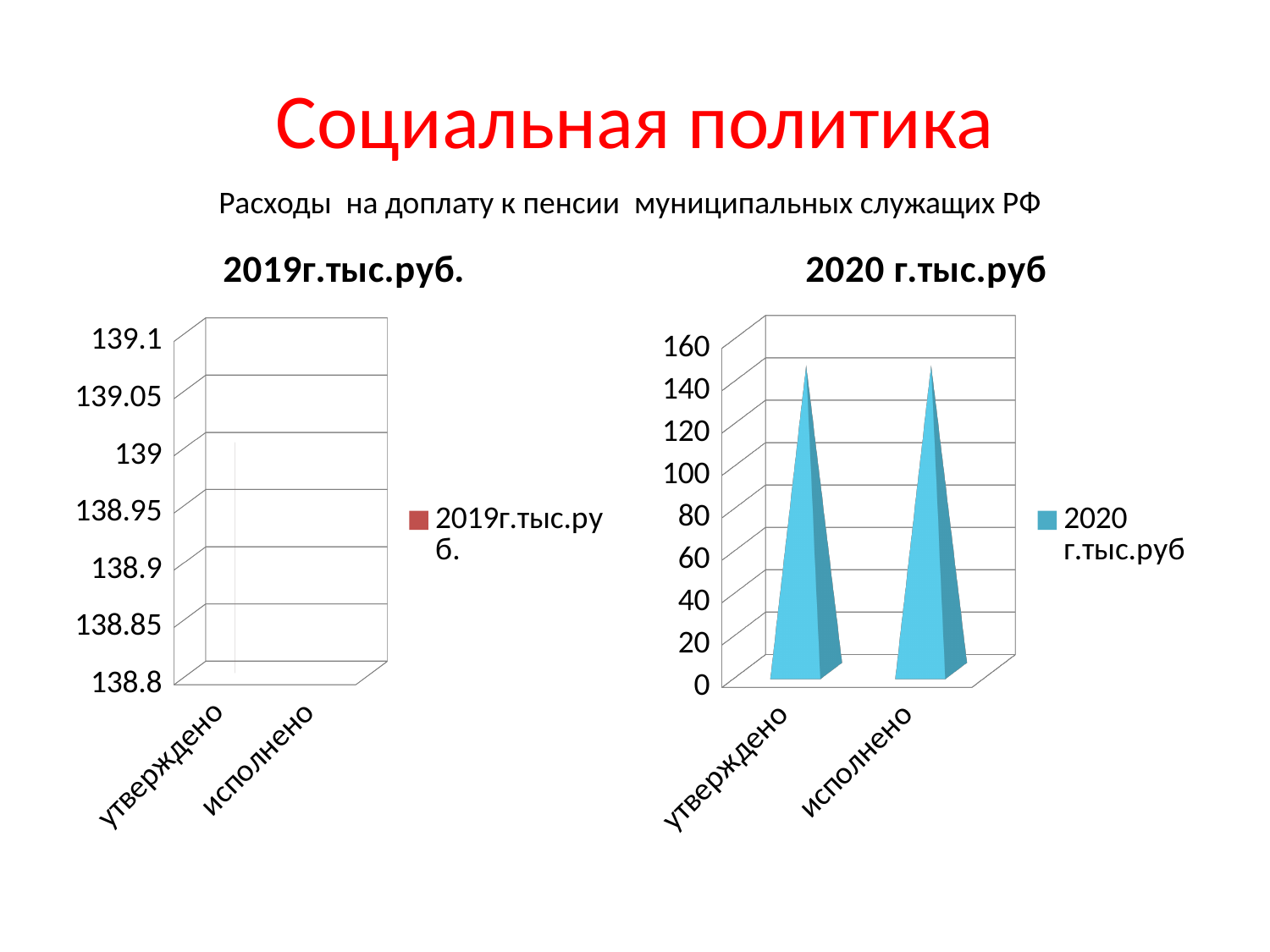
How many series does the legend of the chart titled "2020 г.тыс.руб" list? 1 In the chart titled "2020 г.тыс.руб", is the value for исполнено greater or less than 120? greater In the chart titled "2020 г.тыс.руб", is the value for исполнено greater or less than 160? less How many categories are shown on the x axis of the chart titled "2020 г.тыс.руб"? 2 What is the title of the chart on the left side of the slide? 2019г.тыс.руб. What is the legend entry of the chart on the right side of the slide? 2020 г.тыс.руб How many series does the legend of the chart titled "2019г.тыс.руб." list? 1 How many categories are shown on the x axis of the chart titled "2019г.тыс.руб."? 2 In the chart titled "2020 г.тыс.руб", is the value for утверждено greater or less than 100? greater What kind of chart is the chart titled "2020 г.тыс.руб"? bar chart